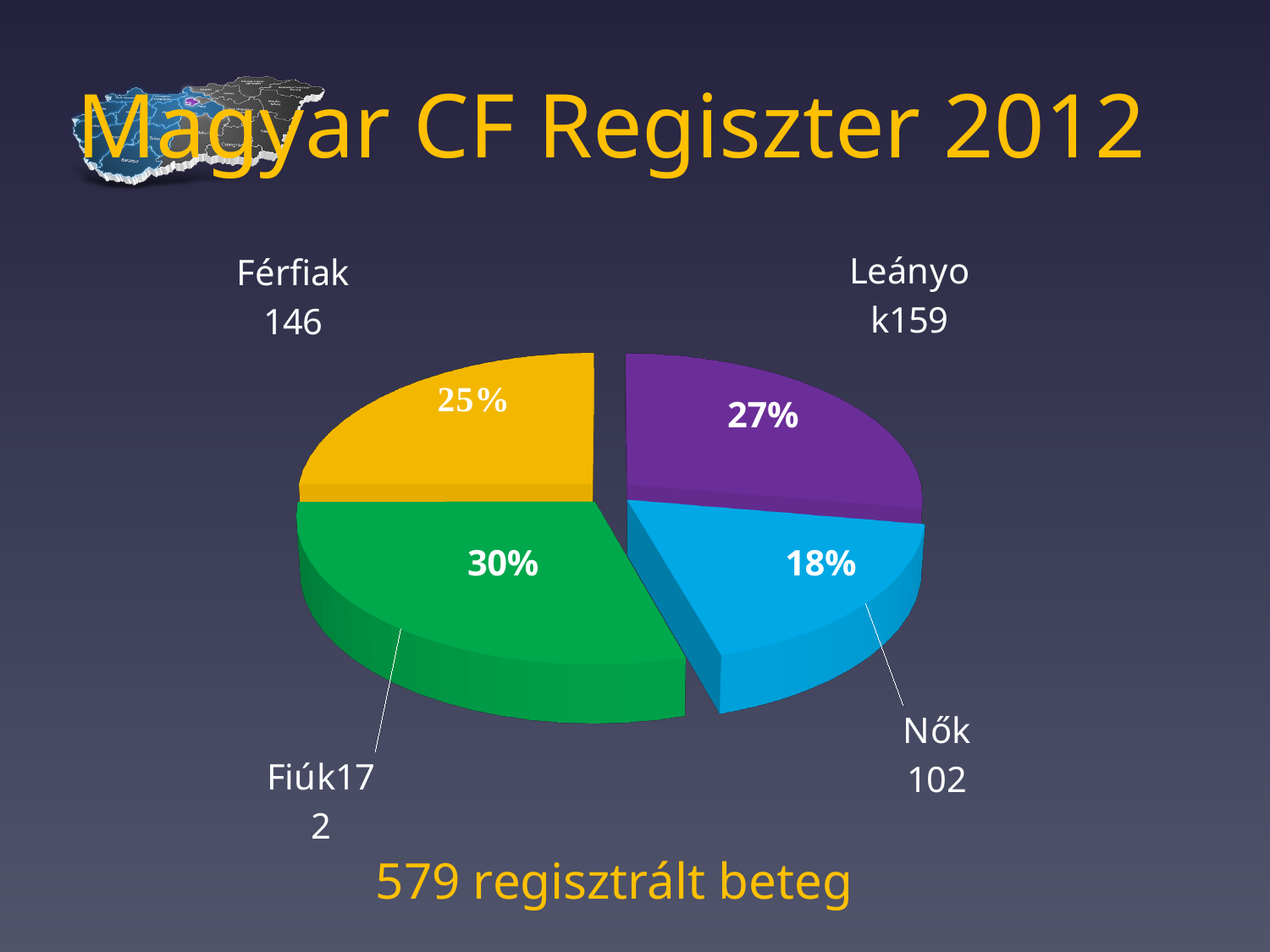
Which category has the smallest slice of the pie? Nők What percentage share does the Leányok slice have? 27% Which is larger, the Leányok slice or the Férfiak slice? Leányok What is the value shown for Férfiak? 146 What percentage share does the Nők slice have? 18% What percentage share does the Fiúk slice have? 30% What is the value shown for Nők? 102 What is the difference in percentage points between the Fiúk slice and the Nők slice? 12 How many slices does the pie chart have? 4 What kind of chart is shown on the slide? pie chart Which category has the largest slice of the pie? Fiúk